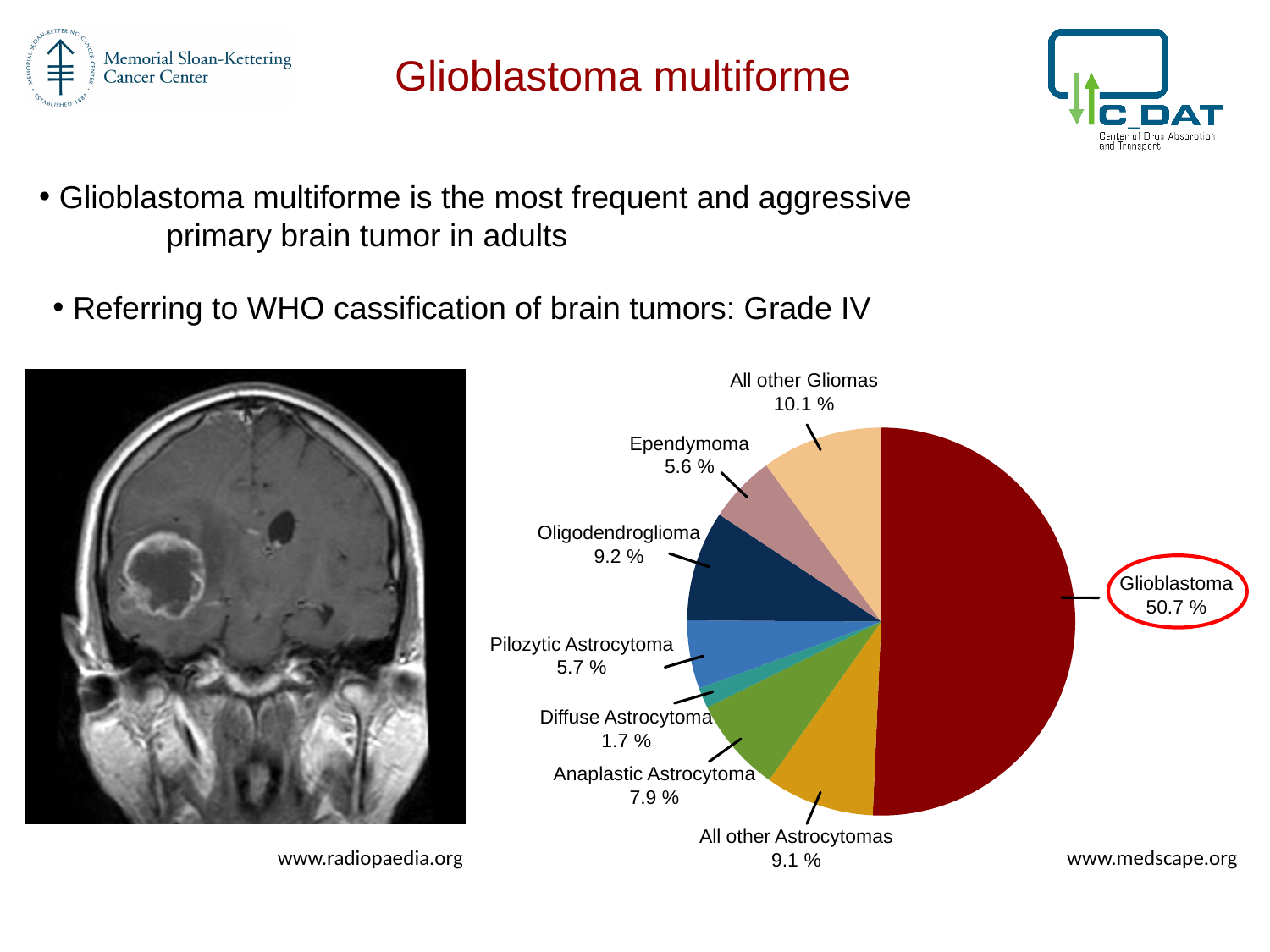
What kind of chart is shown on the slide? pie chart What share of the pie chart does Glioblastoma account for? 50.7 % What is the difference between the Anaplastic Astrocytoma share and the Diffuse Astrocytoma share in the pie chart? 6.2 % Which is larger in the pie chart, All other Gliomas or Anaplastic Astrocytoma? All other Gliomas What is the value shown for All other Gliomas in the pie chart? 10.1 % Which category's label is circled in red on the pie chart? Glioblastoma What is the difference between the Glioblastoma share and the All other Gliomas share in the pie chart? 40.6 % What is the value shown for Diffuse Astrocytoma in the pie chart? 1.7 % Which category has the smallest slice in the pie chart? Diffuse Astrocytoma How many slices does the pie chart have? 8 Which category has the largest slice in the pie chart? Glioblastoma What is the value shown for Oligodendroglioma in the pie chart? 9.2 %